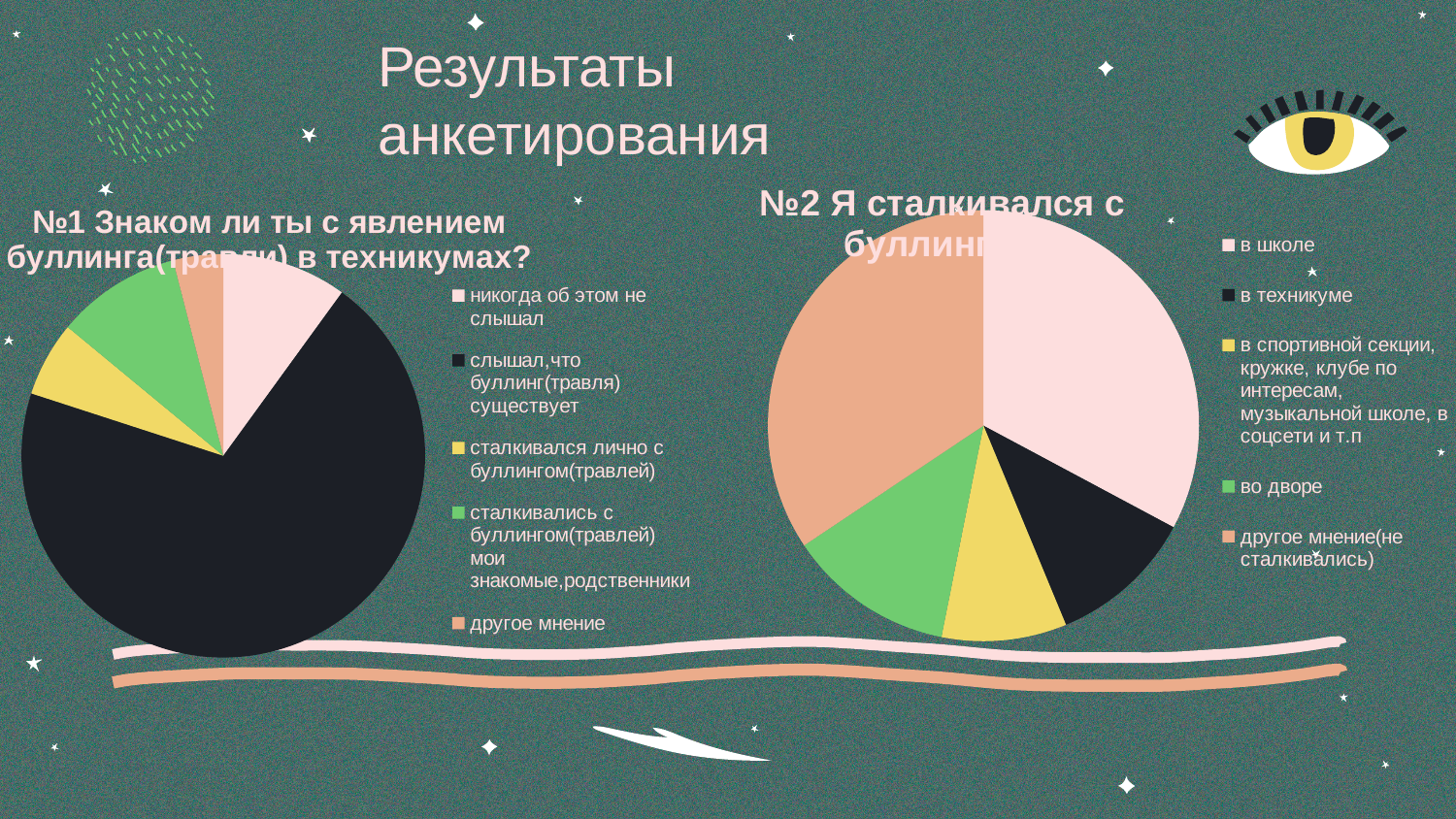
In the right pie chart (№2), which slice is larger: 'во дворе' or 'в спортивной секции, кружке, клубе по интересам, музыкальной школе, в соцсети и т.п'? во дворе How many categories does the legend of the right pie chart (№2) list? 5 In the left pie chart (№1), which slice is larger: 'никогда об этом не слышал' or 'слышал,что буллинг(травля) существует'? слышал,что буллинг(травля) существует In the right pie chart (№2), which slice is larger: 'в школе' or 'в спортивной секции, кружке, клубе по интересам, музыкальной школе, в соцсети и т.п'? в школе What kind of chart is used for question №2 on the right of the slide? pie chart In the left pie chart (№1 Знаком ли ты с явлением буллинга(травли) в техникумах?), which category has the largest slice? слышал,что буллинг(травля) существует How many categories does the legend of the left pie chart (№1) list? 5 What is the title of the left pie chart? №1 Знаком ли ты с явлением буллинга(травли) в техникумах? In the right pie chart (№2 Я сталкивался с буллингом), which category has the smallest slice? в спортивной секции, кружке, клубе по интересам, музыкальной школе, в соцсети и т.п In the right pie chart (№2), what colour is the slice for 'в техникуме'? black What kind of chart is used for question №1 on the left of the slide? pie chart